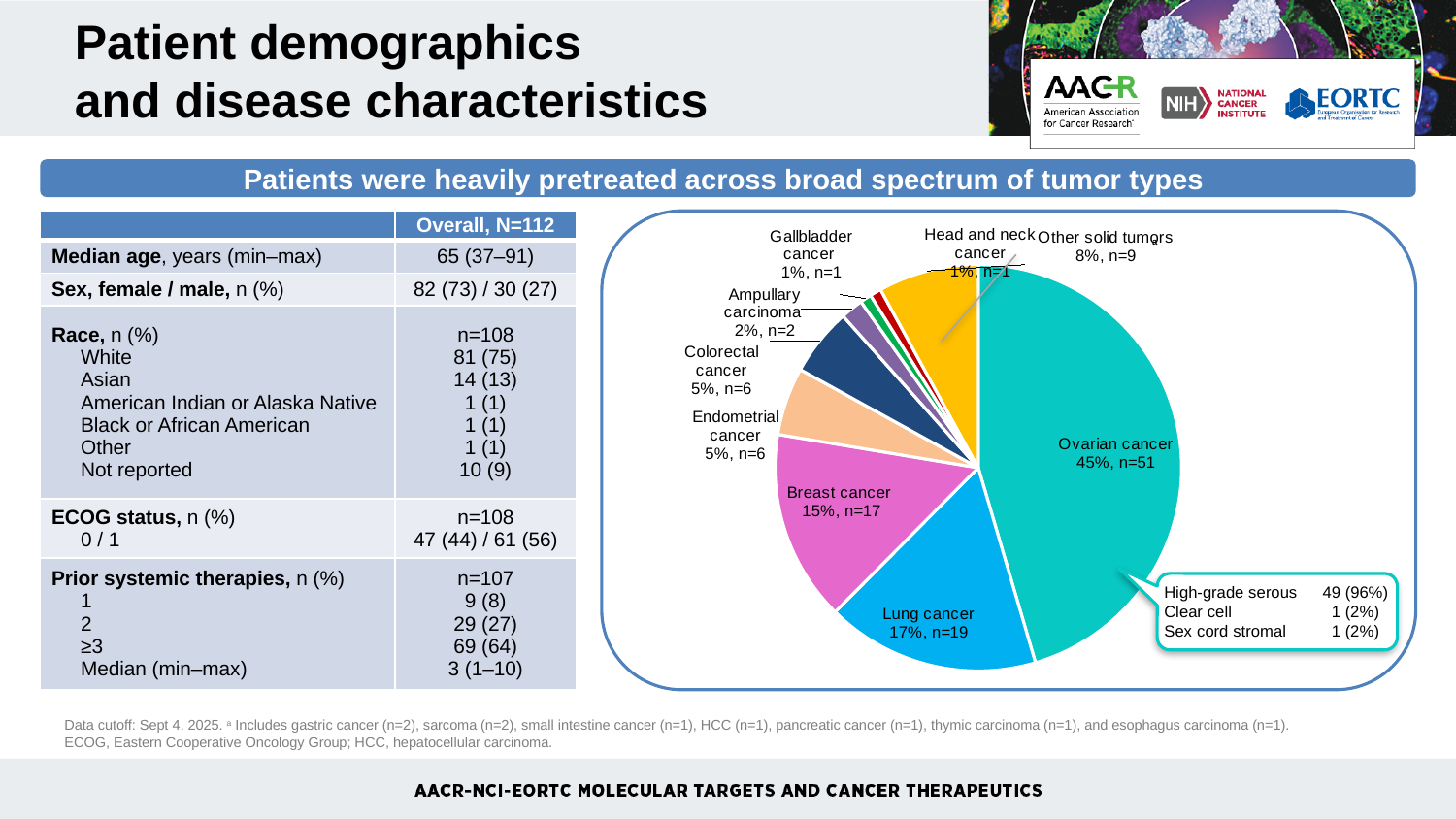
Which tumor type is the largest slice of the pie chart? Ovarian cancer What share of the pie does Ovarian cancer represent? 45% Which slice is larger in the pie chart, Breast cancer or Lung cancer? Lung cancer What percentage of the pie chart is Ampullary carcinoma? 2% In the callout for the Ovarian cancer slice, how many patients had high-grade serous histology? 49 (96%) How many slices does the pie chart have? 9 What is the difference in patient numbers between the Ovarian cancer and Lung cancer slices? 32 What percentage of the pie chart is Breast cancer? 15% How many patients are in the Endometrial cancer slice? n=6 What percentage of the pie chart is Other solid tumors? 8% What type of chart is shown on the slide? pie chart How many patients (n) are in the Lung cancer slice of the pie chart? n=19